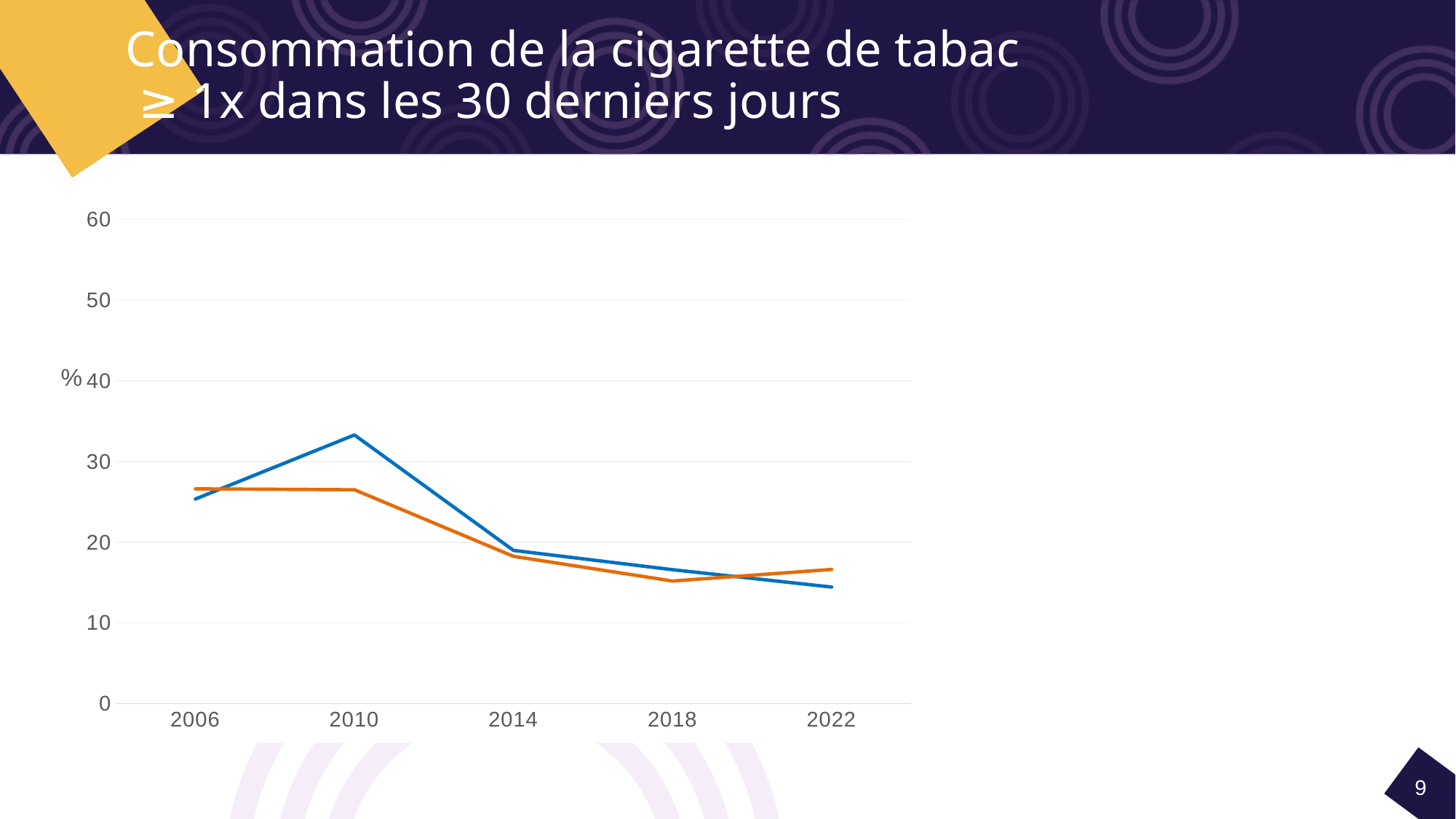
Is the value of the orange line in 2010 greater or less than 30? less Is the value of the orange line in 2006 greater or less than 20? greater In 2010, which line has the higher value, the blue line or the orange line? the blue line Is the value of the blue line in 2010 greater or less than 30? greater How many lines are plotted on the chart? 2 In which year does the blue line reach its highest value? 2010 What kind of chart is shown on the slide? line chart In which year does the blue line reach its lowest value? 2022 What unit is shown on the y axis of the chart? % How many years are plotted along the x axis? 5 Does the blue line rise or fall between 2010 and 2022? fall